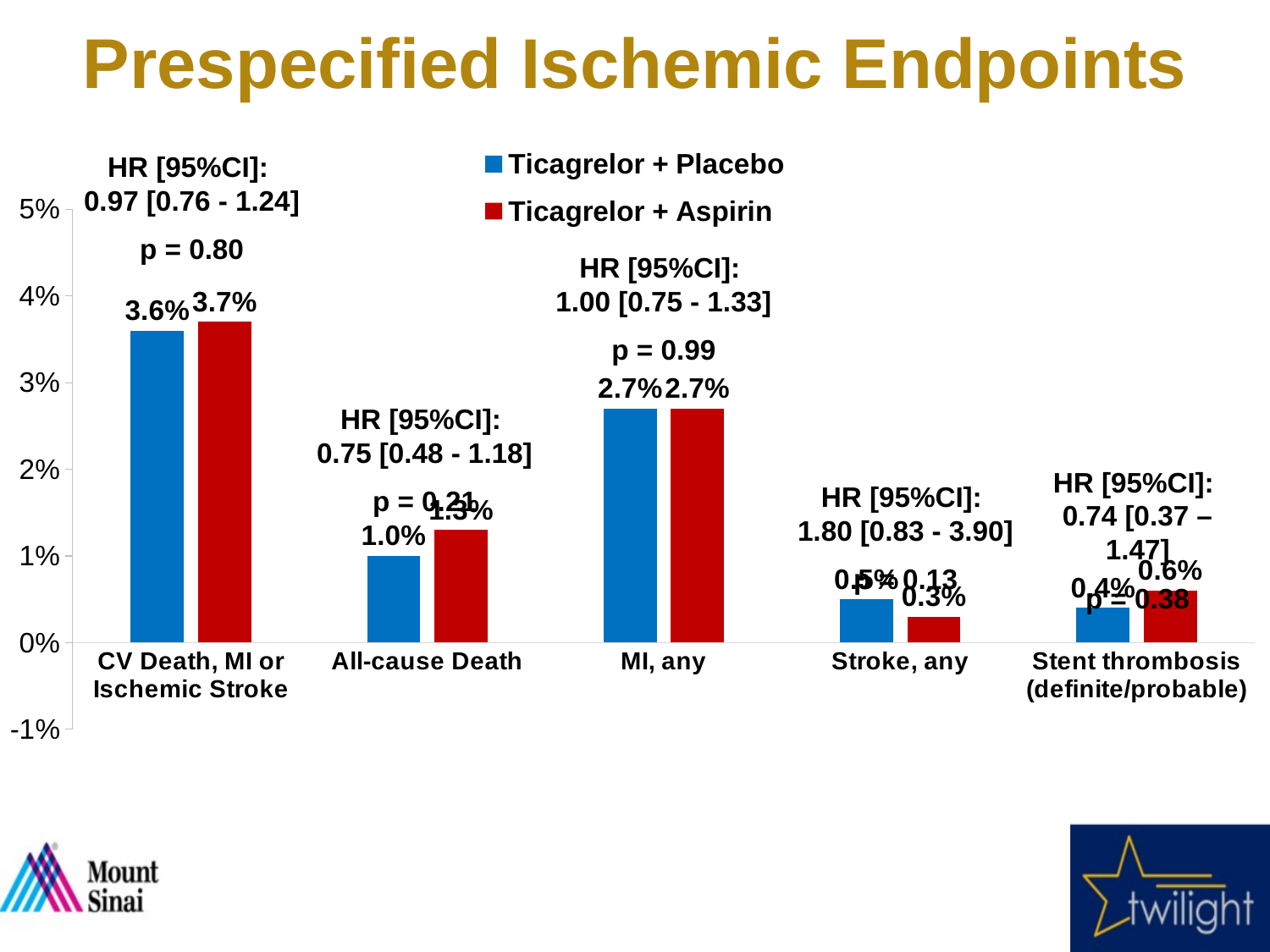
In the All-cause Death category, what is the difference between the Ticagrelor + Aspirin value and the Ticagrelor + Placebo value? 0.3% How many series does the legend list? 2 Is the value for Ticagrelor + Placebo in the MI, any category greater or less than 2%? greater Which category has the highest value for Ticagrelor + Placebo? CV Death, MI or Ischemic Stroke How many endpoint categories are shown on the x axis? 5 In the All-cause Death category, which series has the larger value? Ticagrelor + Aspirin Which category has the lowest value for Ticagrelor + Aspirin? Stroke, any What kind of chart is shown on the slide? bar chart What is the value for Ticagrelor + Placebo in the CV Death, MI or Ischemic Stroke category? 3.6% What is the value for Ticagrelor + Aspirin in the CV Death, MI or Ischemic Stroke category? 3.7% What is the value for Ticagrelor + Placebo in the All-cause Death category? 1.0% What is the value for Ticagrelor + Aspirin in the MI, any category? 2.7%